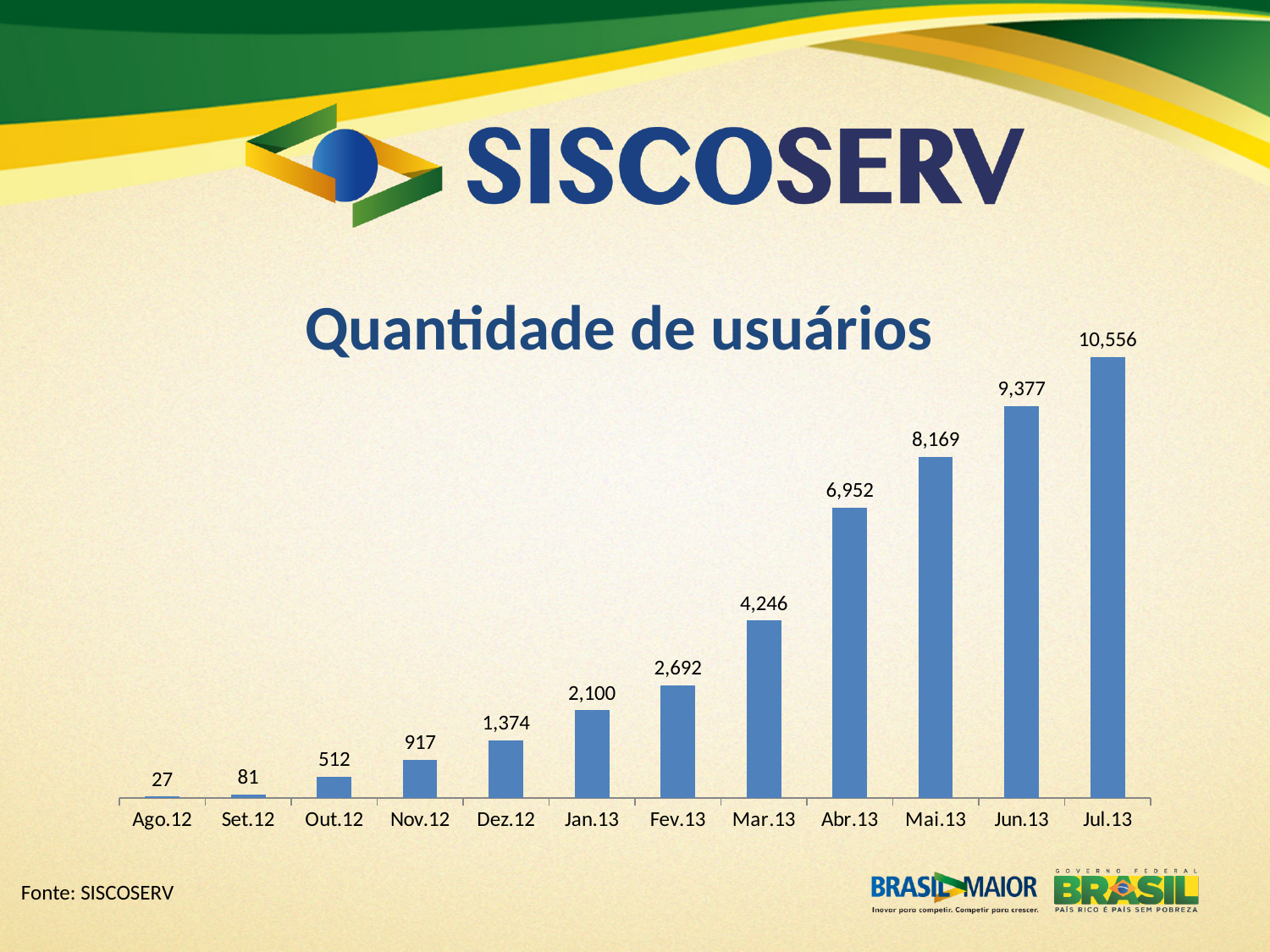
What kind of chart is this? Bar chart What is the difference between the values for Abr.13 and Mar.13? 2,706 What is the value for Mar.13? 4,246 Which month has the lowest value? Ago.12 What is the value for Dez.12? 1,374 Which month has the highest value? Jul.13 Which is larger, the value for Fev.13 or the value for Jan.13? Fev.13 What is the title of the chart? Quantidade de usuários What is the difference between the values for Jul.13 and Jun.13? 1,179 How many months are shown on the x axis? 12 Do the values rise or fall from Ago.12 to Jul.13? Rise What is the value for Jul.13? 10,556